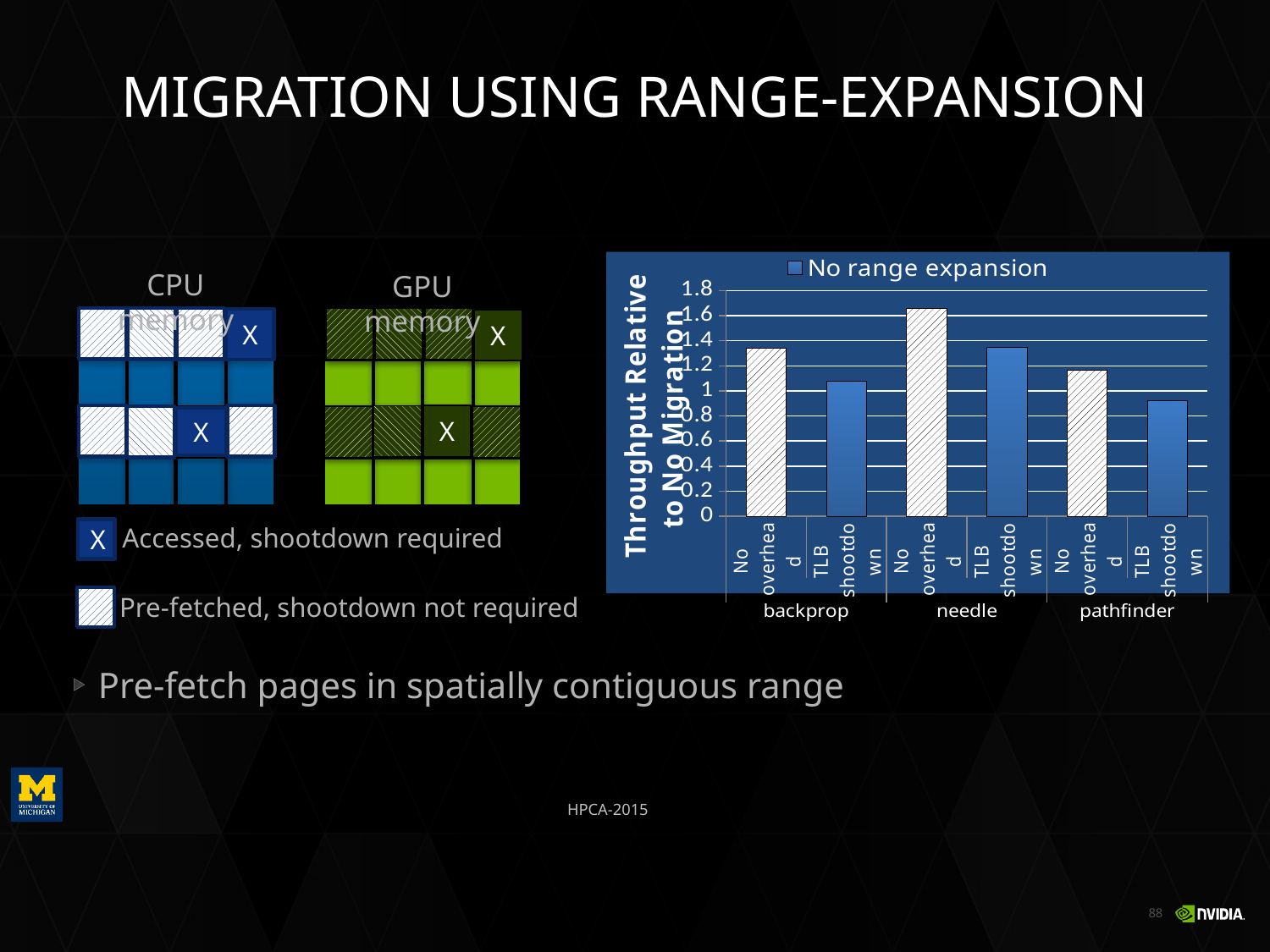
Which bar has the highest value in the chart? needle, No overhead What is the y-axis title of the chart? Throughput Relative to No Migration How many series does the chart legend list? 1 For backprop, which is larger: the No overhead bar or the TLB shootdown bar? No overhead Is the value for needle No overhead greater or less than 1.6? greater What kind of chart is shown on the slide? bar chart How many bars are plotted in the chart? 6 Is the value for backprop No overhead greater or less than 1.2? greater Is the value for pathfinder TLB shootdown greater or less than 1? less Which is larger: the TLB shootdown bar for needle or the TLB shootdown bar for pathfinder? needle Which bar has the lowest value in the chart? pathfinder, TLB shootdown What is the legend entry of the chart? No range expansion